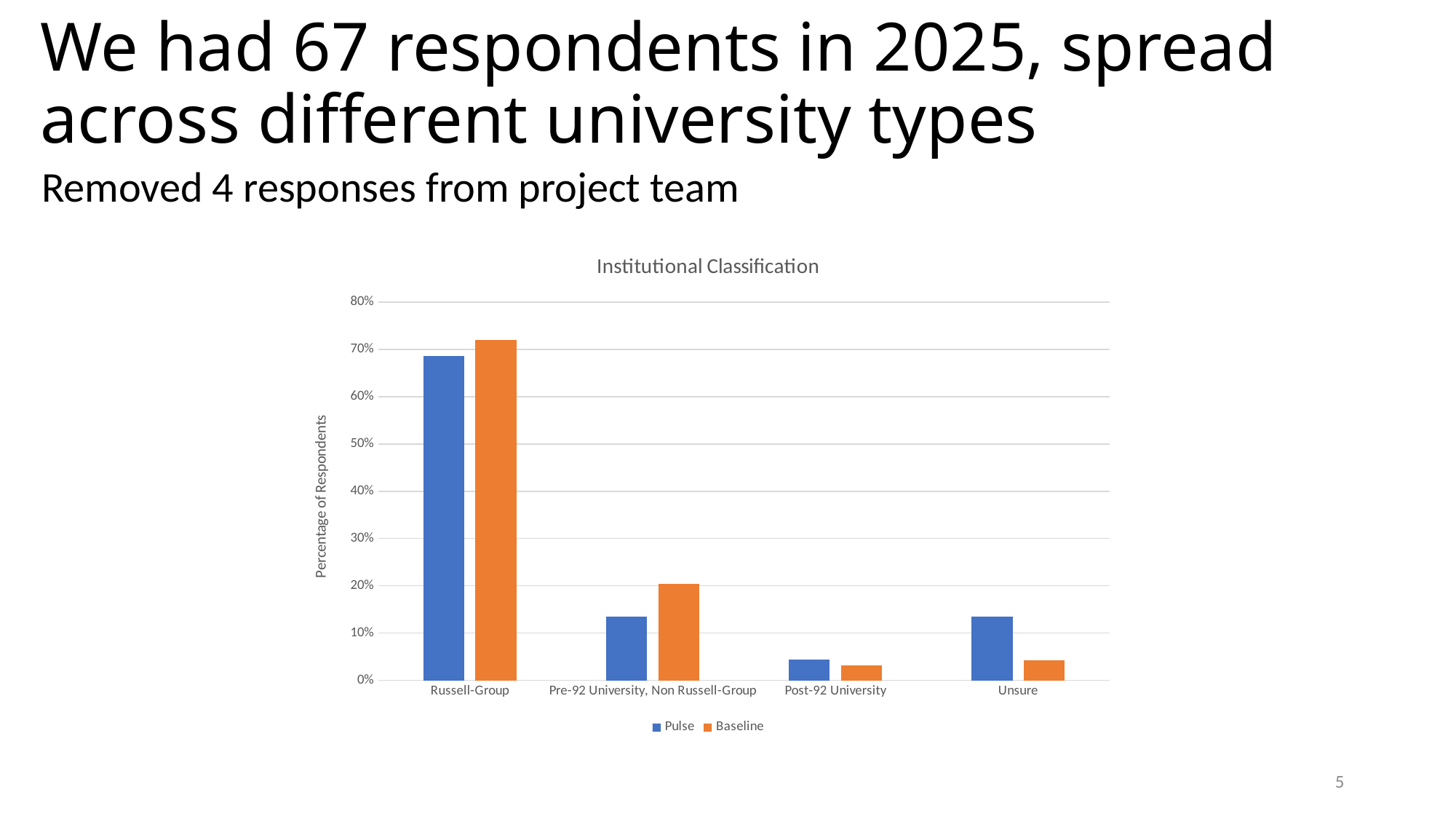
What type of chart is shown on the slide? Bar chart How many series does the legend list? 2 What is the title of the chart? Institutional Classification Is the Baseline value for Pre-92 University, Non Russell-Group greater or less than 10%? greater Is the Pulse value for Russell-Group greater or less than 60%? greater Which category has the lowest Pulse value? Post-92 University Which category has the highest Pulse value? Russell-Group Is the Pulse value for Post-92 University greater or less than 10%? less For Russell-Group, which series has the larger value, Pulse or Baseline? Baseline How many institution categories are shown on the x axis? 4 What is the label on the vertical axis of the chart? Percentage of Respondents For Unsure, which series has the larger value, Pulse or Baseline? Pulse